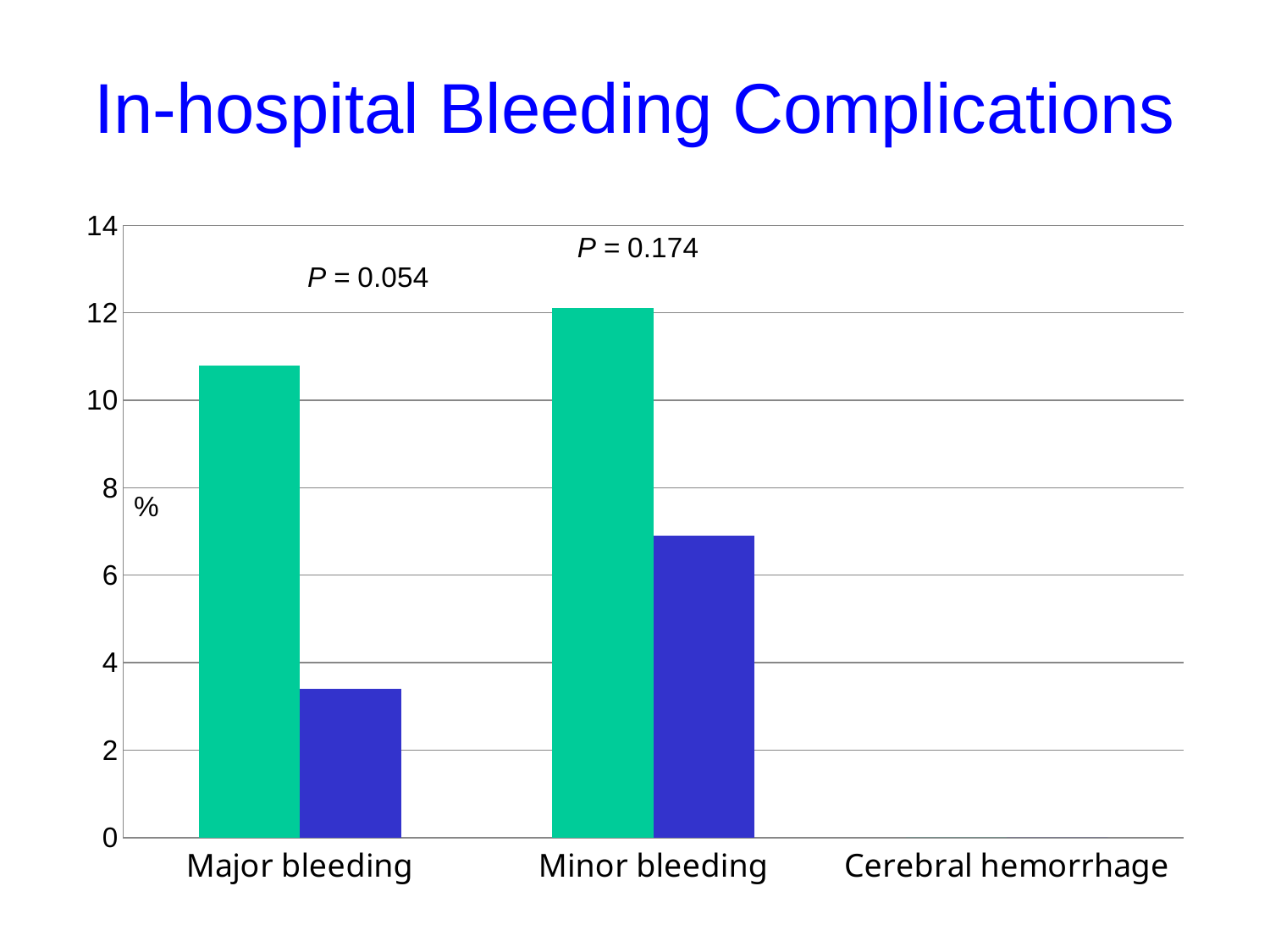
What kind of chart is shown on the slide? bar chart Is the value of the green bar for Major bleeding greater or less than 10? greater Which is larger for Major bleeding, the green bar or the blue bar? the green bar How many categories are shown on the x axis? 3 Is the value of the blue bar for Minor bleeding greater or less than 6? greater What is the title of the chart? In-hospital Bleeding Complications Which category has no bars plotted? Cerebral hemorrhage What P value is printed above the Major bleeding bars? P = 0.054 Is the value of the blue bar for Major bleeding greater or less than 4? less Which category has the tallest bar in the chart? Minor bleeding Which bar is the shortest among the bars plotted? the blue bar for Major bleeding